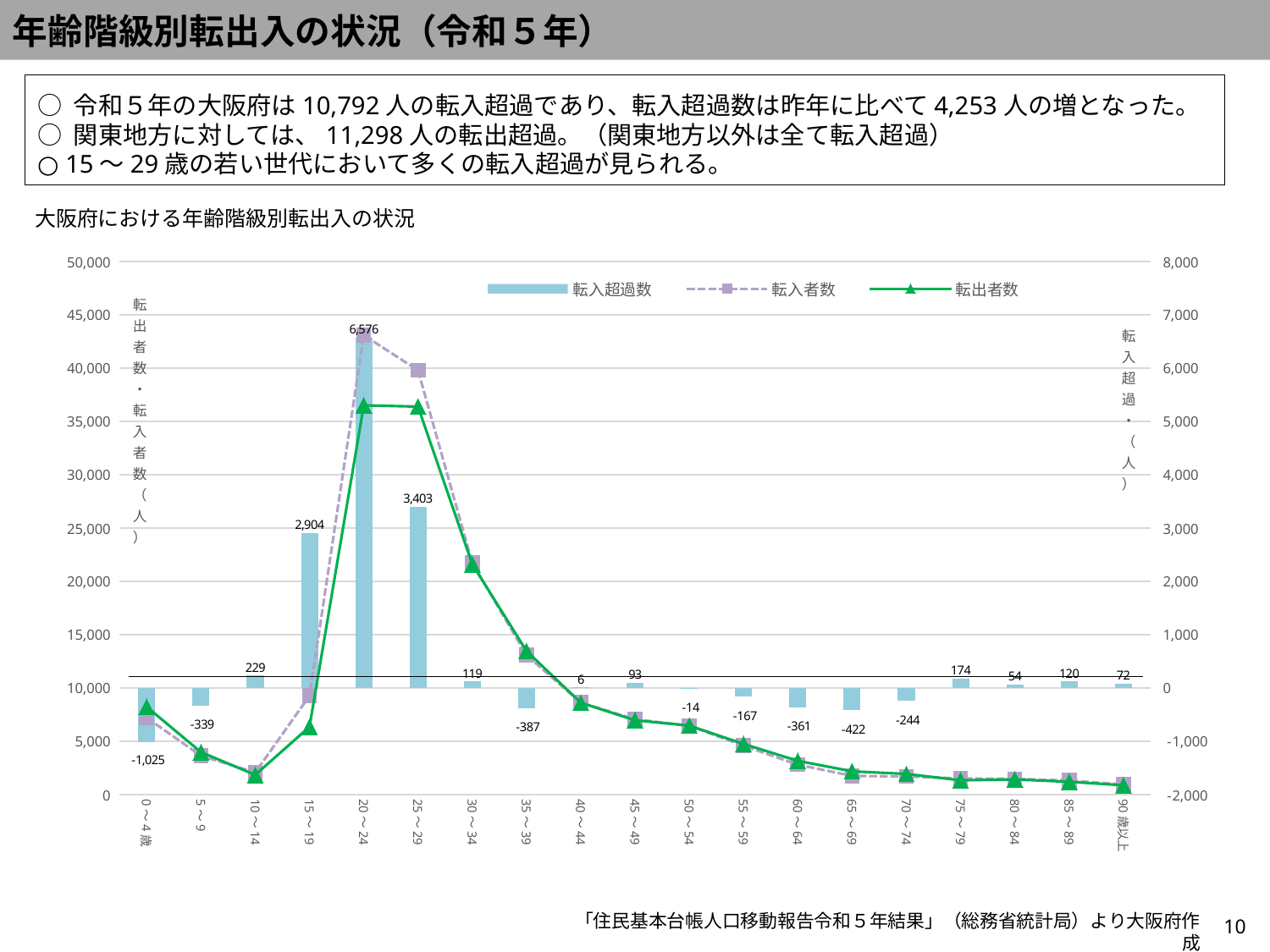
What is the 転入超過数 value for the 15～19 age group? 2,904 What is the 転入超過数 value for the 0～4歳 age group? -1,025 Is the 転入者数 value for the 20～24 age group greater or less than 40,000? greater Which age group has the highest 転入超過数? 20～24 What is the 転入超過数 value for the 20～24 age group? 6,576 Which age group has the lowest 転入超過数? 0～4歳 How many series does the legend list? 3 Which has the larger 転入超過数, the 15～19 group or the 25～29 group? 25～29 What is the difference between the 転入超過数 for 20～24 and for 25～29? 3,173 How many age groups are shown on the x axis? 19 Which series is drawn with a green line and triangle markers? 転出者数 What kind of chart is used to show 転入超過数? bar chart